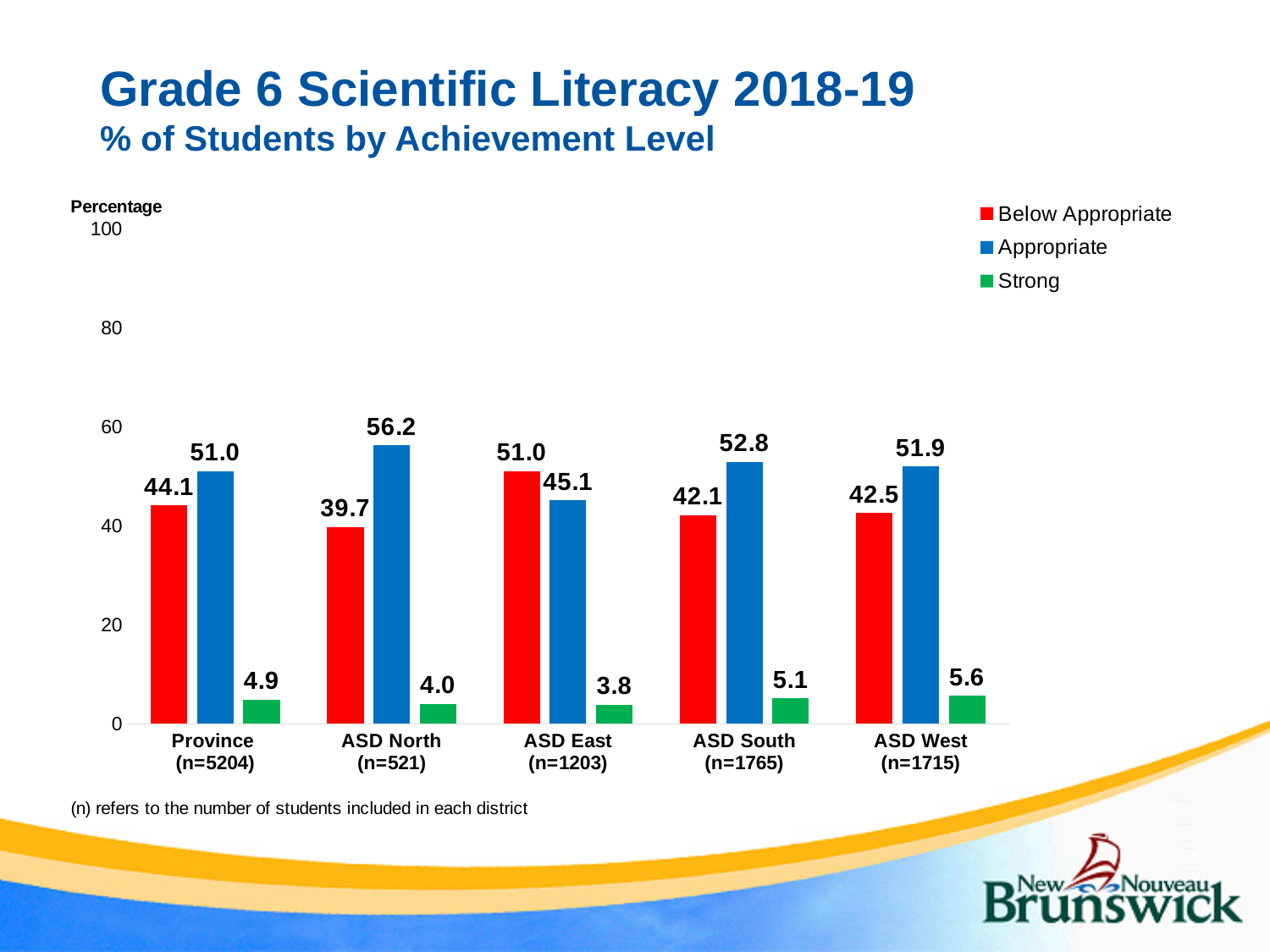
How many categories are shown on the x axis? 5 What is the Appropriate value for ASD North? 56.2 What kind of chart is shown on the slide? Bar chart Which district has the highest Appropriate value? ASD North What is the number of students (n) for ASD South? 1765 How many series does the legend list? 3 What is the Strong value for ASD West? 5.6 Is the Below Appropriate value for Province greater or less than 40? greater What is the difference between the Appropriate and Below Appropriate values for ASD North? 16.5 What is the Below Appropriate value for ASD East? 51.0 Which category has the lowest Strong value? ASD East Which is larger for ASD East: Below Appropriate or Appropriate? Below Appropriate